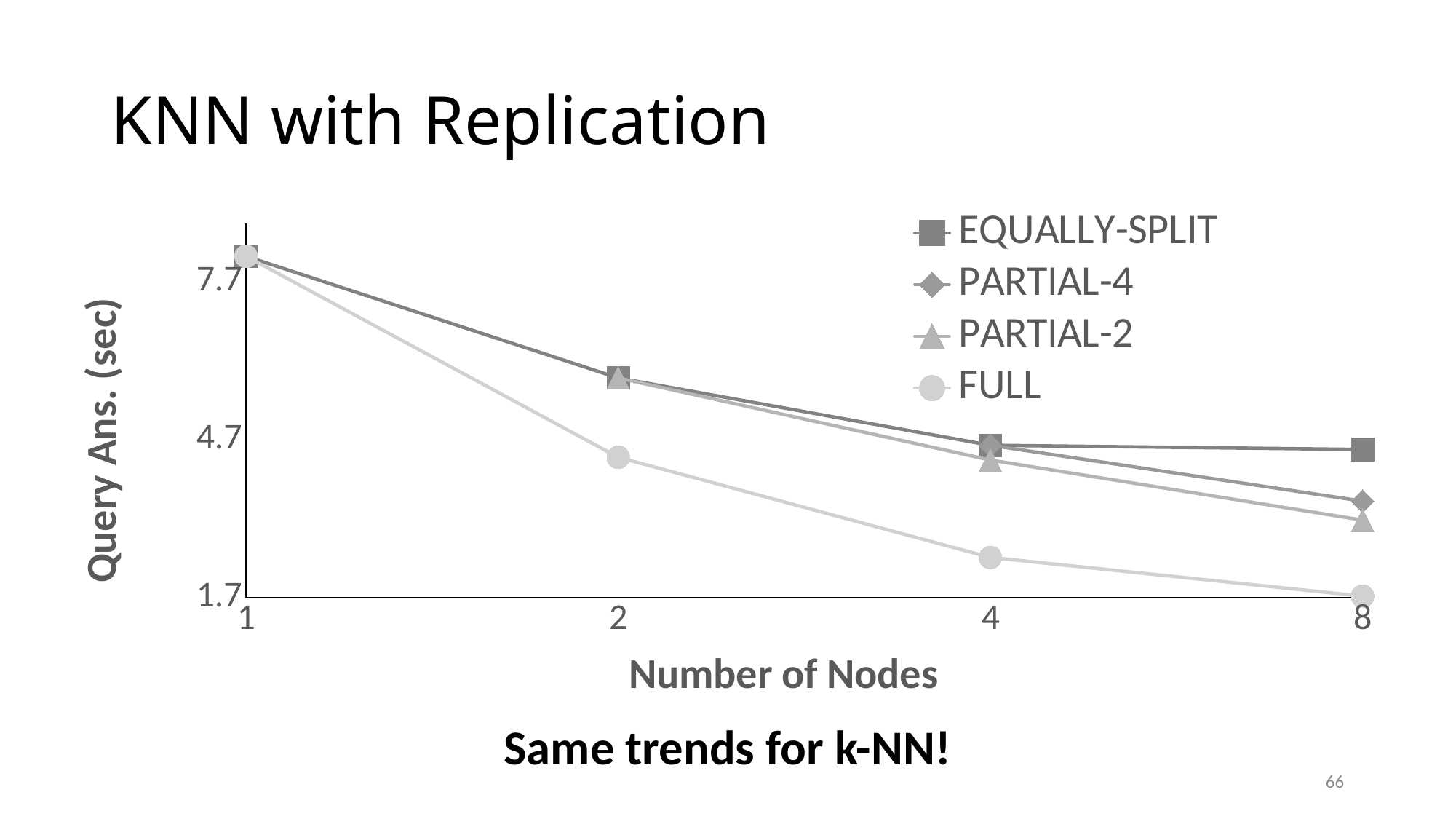
Is the query answering time for EQUALLY-SPLIT at 2 nodes greater or less than 4.7? greater Which series has the lowest query answering time at 4 nodes? FULL Which series has the lowest query answering time at 8 nodes? FULL Does the query answering time for EQUALLY-SPLIT rise or fall as the number of nodes increases from 1 to 8? fall Is the query answering time for FULL at 2 nodes greater or less than 4.7? less Does the query answering time for FULL rise or fall as the number of nodes increases? fall At 8 nodes, which has the larger query answering time, EQUALLY-SPLIT or FULL? EQUALLY-SPLIT What is the title of the x axis? Number of Nodes How many series does the legend list? 4 Which series has the highest query answering time at 8 nodes? EQUALLY-SPLIT What kind of chart is shown on the slide? line chart